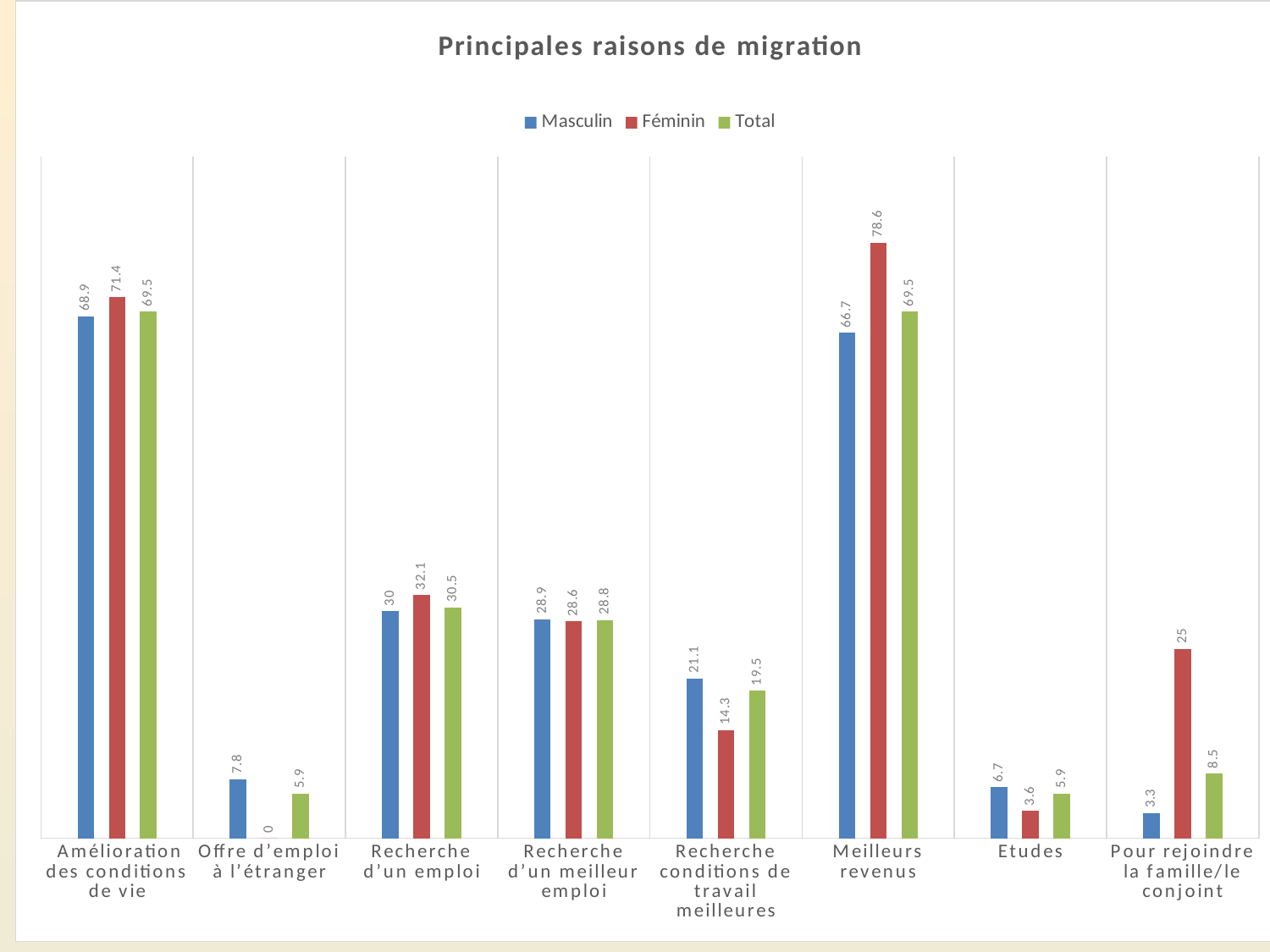
What kind of chart is shown? Bar chart What is the title of the chart? Principales raisons de migration What is the Total value for Recherche d'un emploi? 30.5 Which category has the highest Féminin value? Meilleurs revenus Which category has the lowest Masculin value? Pour rejoindre la famille/le conjoint What is the Féminin value for Offre d'emploi à l'étranger? 0 What is the Féminin value for Meilleurs revenus? 78.6 What is the Masculin value for Amélioration des conditions de vie? 68.9 How many series does the legend list? 3 Which is larger for Recherche conditions de travail meilleures, the Masculin value or the Féminin value? Masculin What is the difference between the Féminin and Masculin values for Pour rejoindre la famille/le conjoint? 21.7 How many categories are shown on the x axis? 8